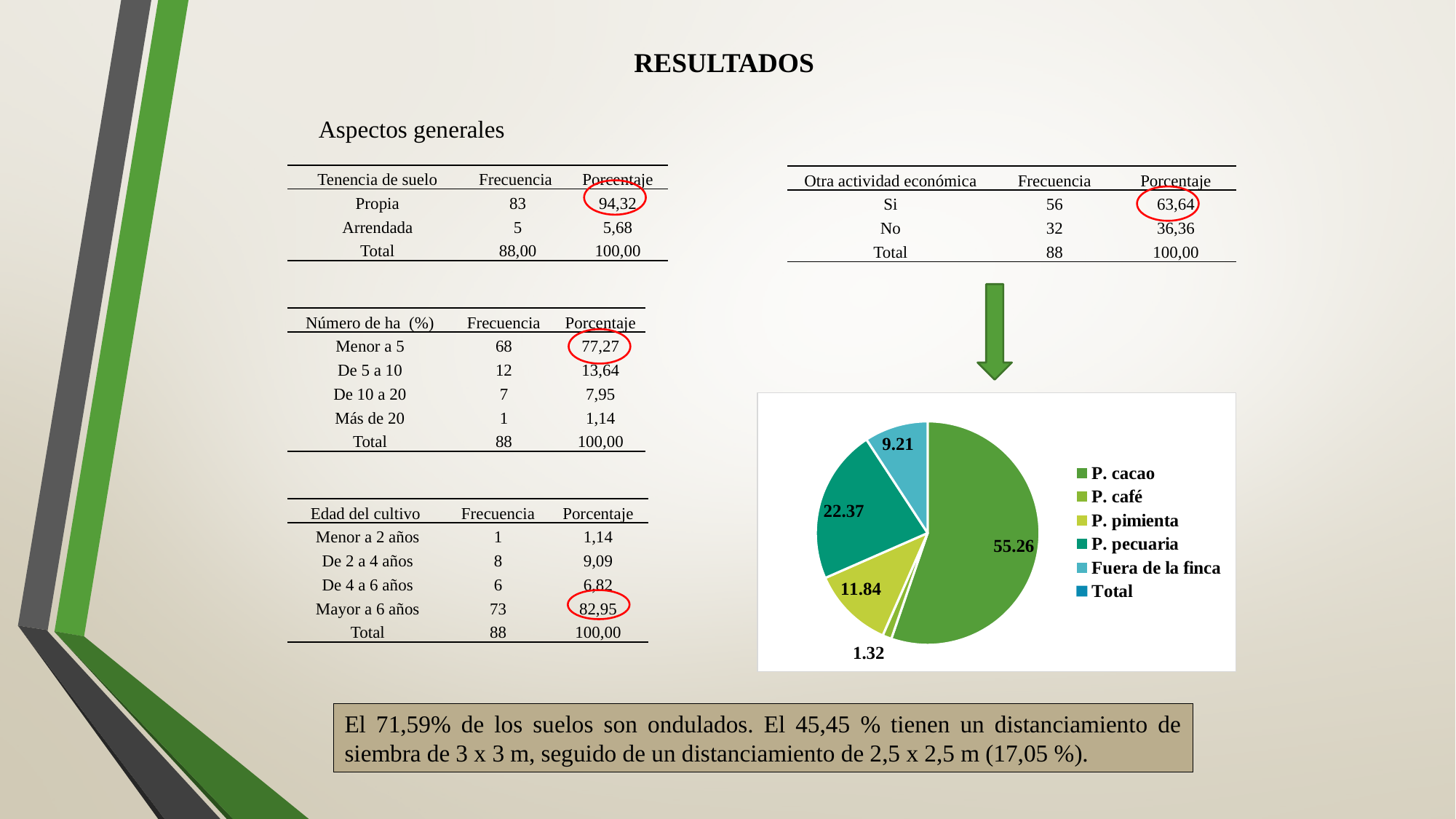
What colour is the P. cacao slice in the pie chart? green In the pie chart, what is the value for P. pimienta? 11.84 In the pie chart, what is the difference between the values for P. cacao and P. pecuaria? 32.89 In the pie chart, what is the value for P. cacao? 55.26 In the pie chart, what is the value for Fuera de la finca? 9.21 Which category has the smallest slice in the pie chart? P. café How many entries does the legend of the pie chart list? 6 What type of chart is shown on the slide? pie chart In the pie chart, which is larger: P. pimienta or Fuera de la finca? P. pimienta In the pie chart, what is the value for P. pecuaria? 22.37 Which category has the largest slice in the pie chart? P. cacao In the pie chart, what is the value for P. café? 1.32